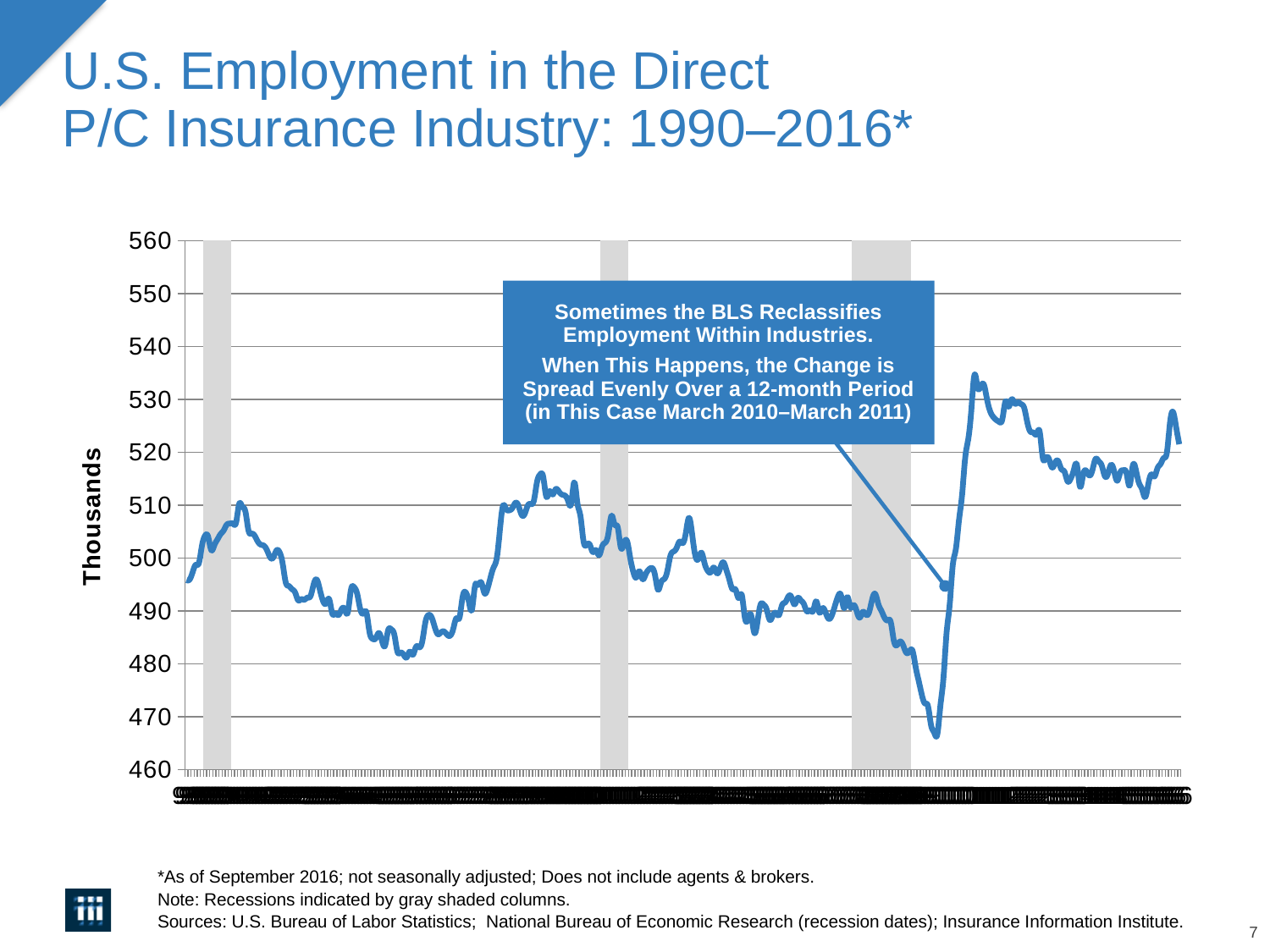
Is the peak of the line just before the second gray shaded column greater or less than 510? greater Is the value at the end of the line (2016) greater or less than 510? greater Comparing the start of the line to the end of the line, does employment rise or fall overall? rise How many gray shaded recession columns are shown on the chart? 3 What is the highest value shown on the vertical axis? 560 Is the highest point of the line greater or less than 530? greater What kind of chart is shown on the slide? line chart What is the label on the vertical axis of the chart? Thousands Which is higher: the peak of the line after the third gray shaded column or the peak before the second gray shaded column? the peak after the third gray shaded column